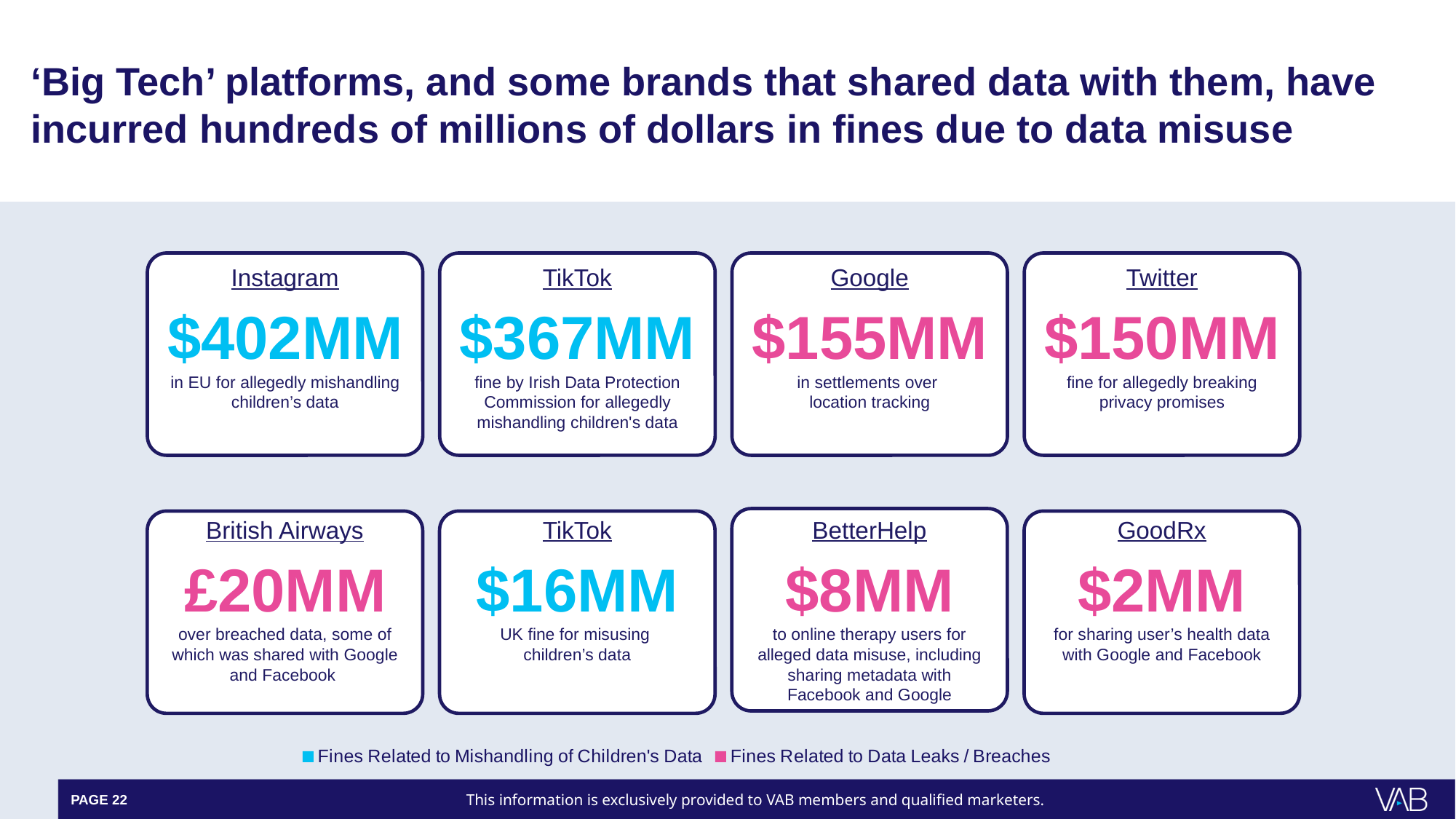
What is the fine amount shown for Google? $155MM Which company has the largest fine shown on the slide? Instagram What is the fine amount shown for GoodRx? $2MM What is the difference between the Instagram fine and the TikTok Irish Data Protection Commission fine? $35MM How many categories does the legend list? 2 Which company has the smallest fine shown on the slide? GoodRx What is the fine amount shown for British Airways? £20MM What is the fine amount shown for Instagram? $402MM Which is larger, the Google fine or the Twitter fine? Google According to the legend, what do the pink values represent? Fines Related to Data Leaks / Breaches What is the UK fine amount shown for TikTok for misusing children's data? $16MM How many fine boxes are shown on the slide? 8